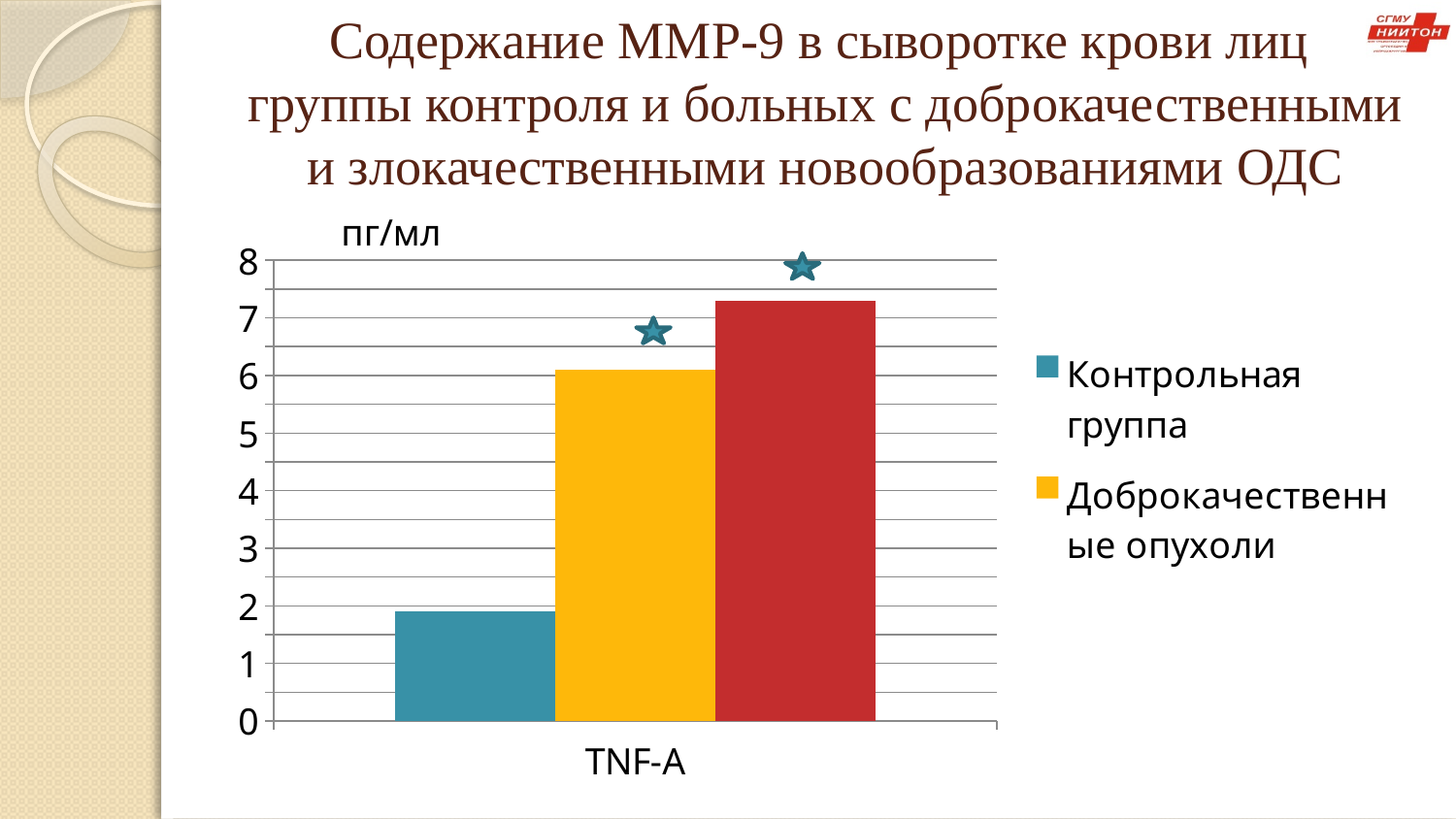
Is the value for Доброкачественные опухоли greater or less than 7? less Is the value for Контрольная группа greater or less than 1? greater What kind of chart is shown on the slide? bar chart What unit is shown above the y axis of the chart? пг/мл Which series has the lowest bar in the chart? Контрольная группа Which is larger, the value for Контрольная группа or the value for Доброкачественные опухоли? Доброкачественные опухоли What is the category label on the x axis of the chart? TNF-A How many series does the legend list? 2 How many categories are shown on the x axis of the chart? 1